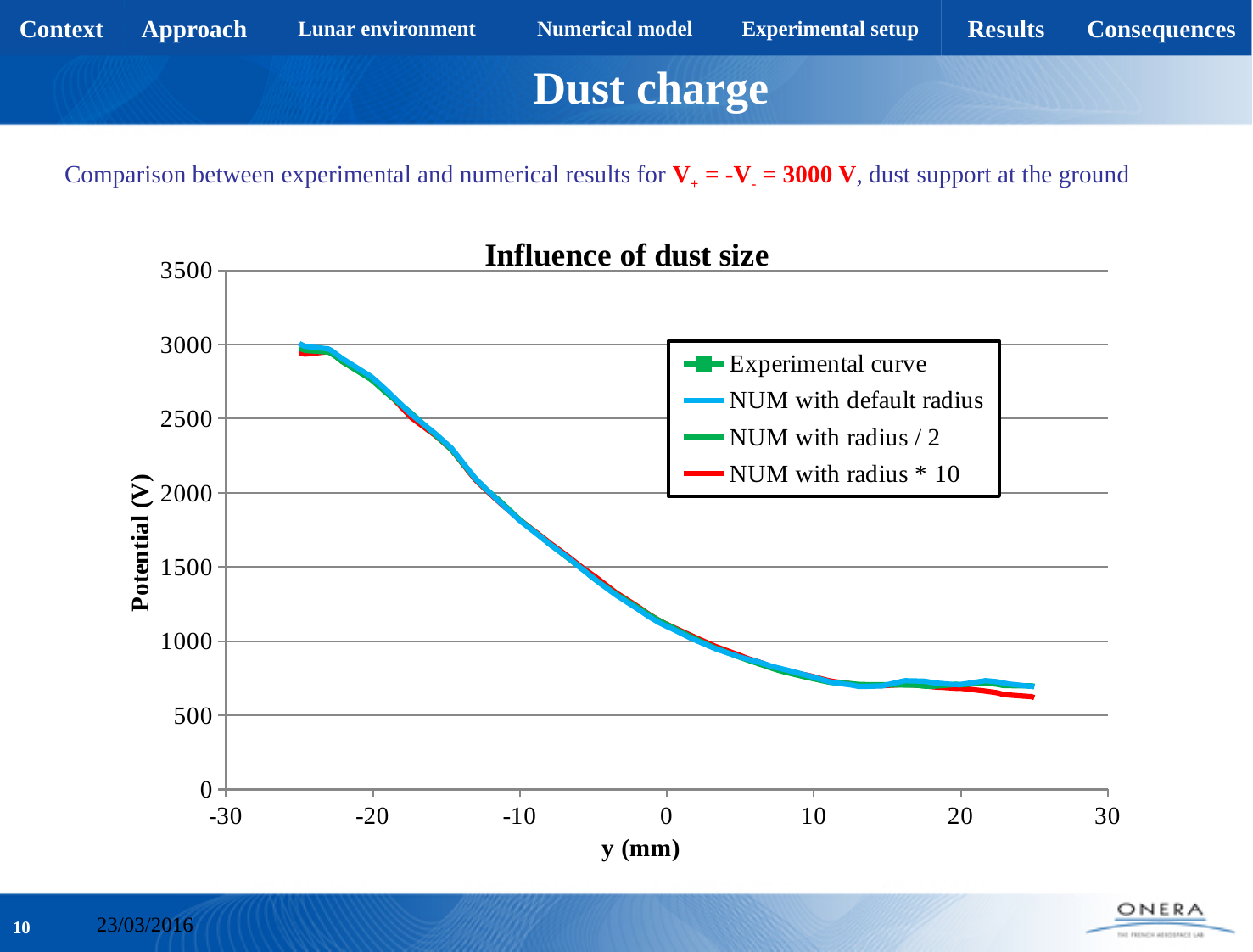
How many series does the legend of the chart list? 4 Is the potential at y = 20 mm greater or less than 500? greater Do the curves rise or fall as y (mm) increases from -30 to 30? fall What is the label of the vertical axis of the chart? Potential (V) At y = 25 mm, which series has the lowest potential? NUM with radius * 10 What is the title of the chart? Influence of dust size What is the maximum value shown on the vertical axis of the chart? 3500 Is the potential at y = 10 mm greater or less than 1000? less Is the potential at y = -10 mm greater or less than 2000? less What kind of chart is shown on the slide? line chart